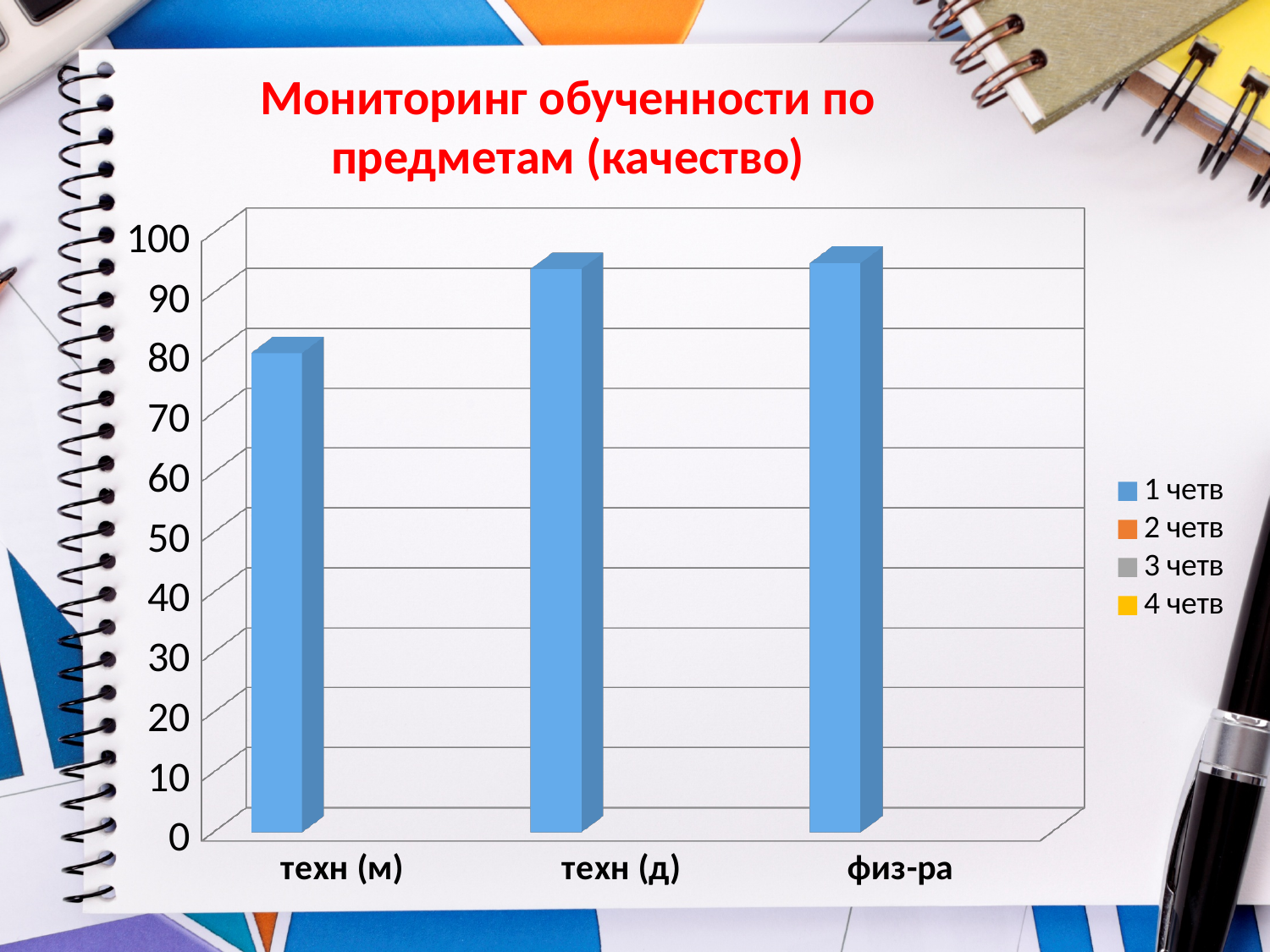
Is the value for техн (д) greater or less than 90? greater Is the value for техн (м) greater or less than 70? greater Which is larger, the value for техн (м) or the value for техн (д)? техн (д) Which category has the lowest bar in the chart? техн (м) Is the value for физ-ра greater or less than 90? greater How many categories are shown on the x axis of the chart? 3 Which legend series is the only one with bars plotted in the chart? 1 четв What is the title of the chart? Мониторинг обученности по предметам (качество) Which is larger, the value for техн (м) or the value for физ-ра? физ-ра How many series does the legend list? 4 What kind of chart is shown on the slide? bar chart